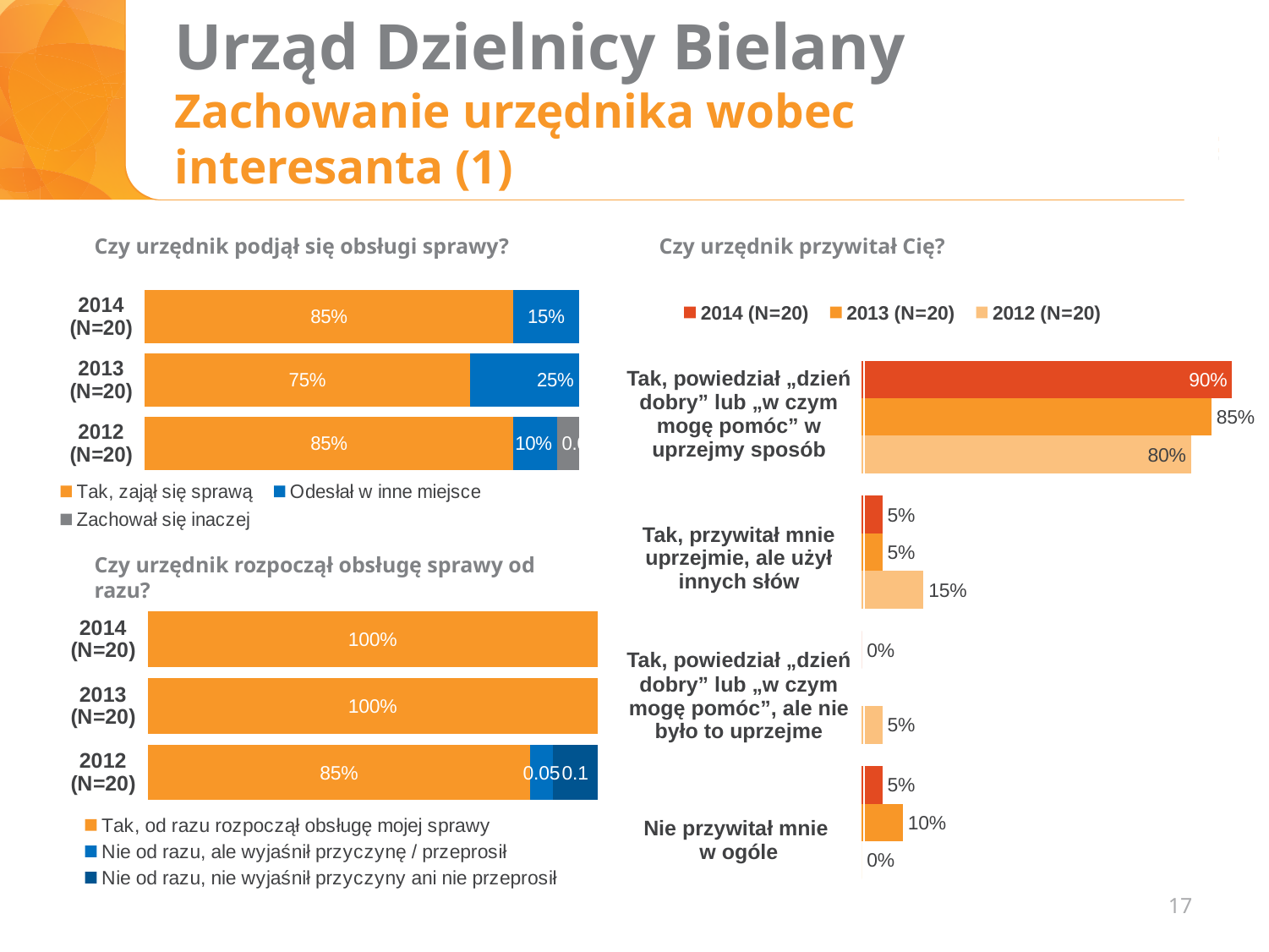
How many categories are shown in the chart 'Czy urzędnik przywitał Cię?'? 4 In the chart 'Czy urzędnik podjął się obsługi sprawy?', what percentage for 2014 (N=20) is 'Tak, zajął się sprawą'? 85% In the chart 'Czy urzędnik przywitał Cię?', which is larger for 'Nie przywitał mnie w ogóle': the 2013 (N=20) value or the 2014 (N=20) value? 2013 (N=20) What type of chart is 'Czy urzędnik przywitał Cię?'? bar chart How many series does the legend of the chart 'Czy urzędnik podjął się obsługi sprawy?' list? 3 In the chart 'Czy urzędnik podjął się obsługi sprawy?', which year has the lowest 'Tak, zajął się sprawą' share? 2013 (N=20) In the chart 'Czy urzędnik podjął się obsługi sprawy?', what is the difference between the 'Odesłał w inne miejsce' values for 2013 and 2014? 10% In the chart 'Czy urzędnik przywitał Cię?', what is the 2012 (N=20) value for 'Tak, przywitał mnie uprzejmie, ale użył innych słów'? 15% In the chart 'Czy urzędnik przywitał Cię?', what is the 2014 (N=20) value for 'Tak, powiedział „dzień dobry” lub „w czym mogę pomóc” w uprzejmy sposób'? 90% In the chart 'Czy urzędnik rozpoczął obsługę sprawy od razu?', which year has the lowest 'Tak, od razu rozpoczął obsługę mojej sprawy' share? 2012 (N=20) In the chart 'Czy urzędnik rozpoczął obsługę sprawy od razu?', what is the 'Tak, od razu rozpoczął obsługę mojej sprawy' value for 2013 (N=20)? 100% In the chart 'Czy urzędnik podjął się obsługi sprawy?', what is the 'Odesłał w inne miejsce' value for 2013 (N=20)? 25%